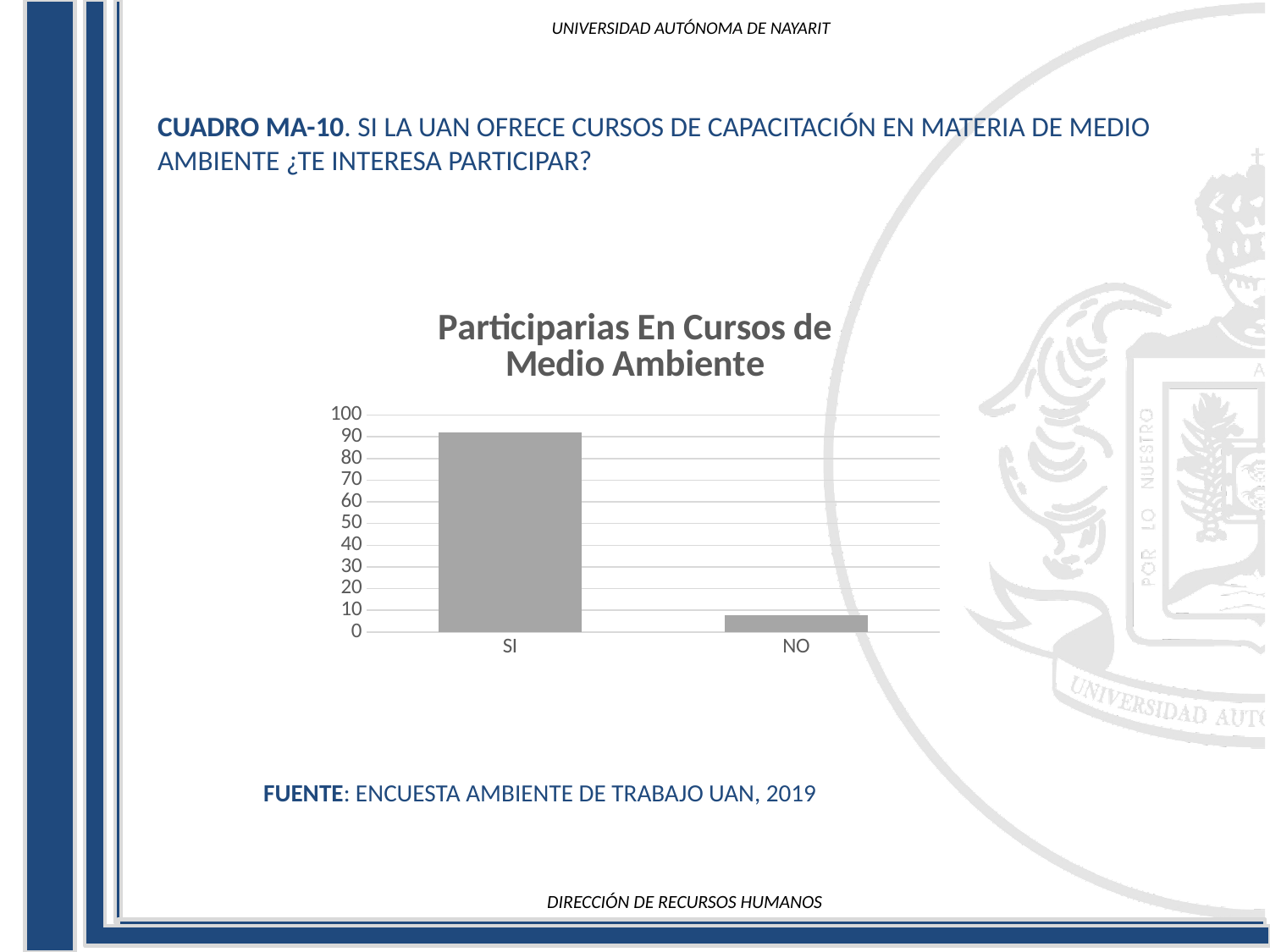
Which is larger, the value for SI or the value for NO? SI What is the highest value shown on the y axis of the chart? 100 Is the value for NO greater or less than 20? less Which category has the lowest value in the chart? NO How many categories are shown on the x axis of the chart? 2 What is the title of the chart? Participarias En Cursos de Medio Ambiente Is the value for SI greater or less than 50? greater What kind of chart is shown on the slide? bar chart Do the values rise or fall moving from SI to NO along the x axis? fall Which category has the highest value in the chart? SI Is the value for SI greater or less than 80? greater